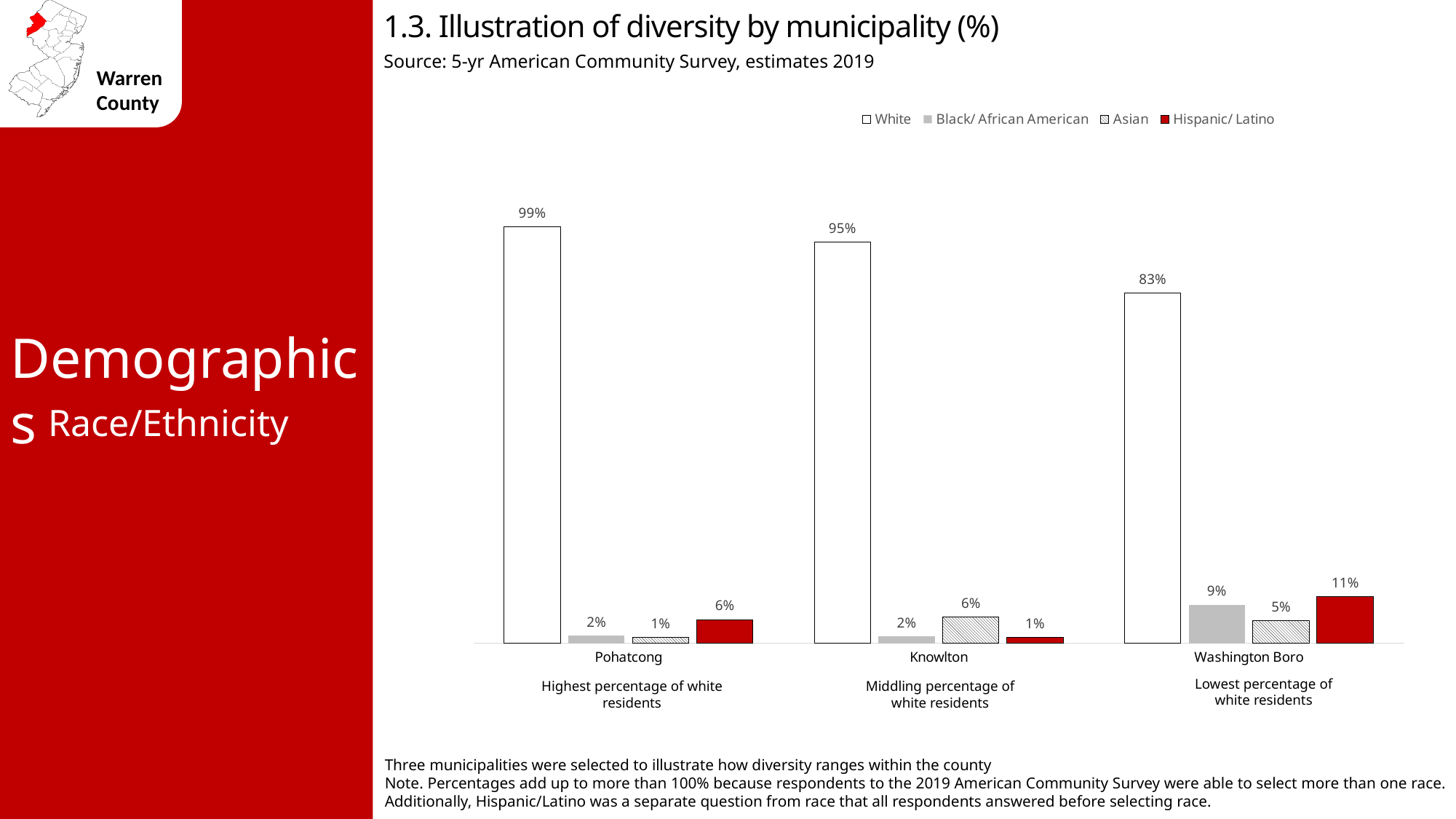
What is the difference between the White percentage in Pohatcong and in Washington Boro? 16% What is the source cited for the chart? 5-yr American Community Survey, estimates 2019 What is the White percentage for Pohatcong? 99% What is the Black/ African American percentage for Washington Boro? 9% How many series does the legend list? 4 How many municipalities are shown on the chart? 3 What kind of chart is shown on the slide? Bar chart Which municipality has the lowest White percentage? Washington Boro Which is larger, the Hispanic/ Latino percentage in Pohatcong or in Knowlton? Pohatcong Which municipality has the highest Hispanic/ Latino percentage? Washington Boro What is the Hispanic/ Latino percentage for Washington Boro? 11% What is the Asian percentage for Knowlton? 6%